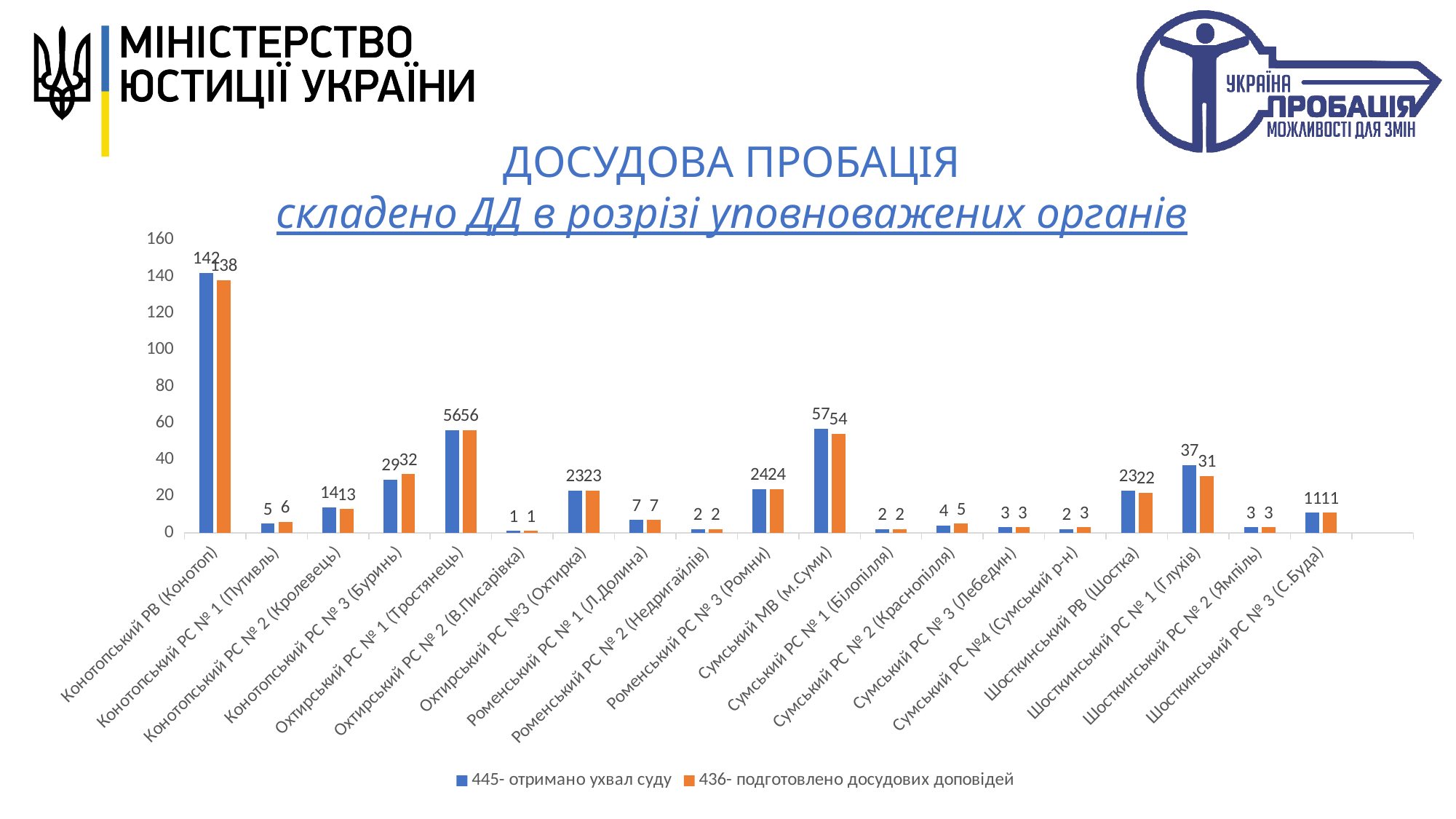
What is the difference between the blue and orange values for Шосткинський РС № 1 (Глухів)? 6 What is the value of the blue series (445- отримано ухвал суду) for Конотопський РВ (Конотоп)? 142 Which category has the highest value in the blue series (445- отримано ухвал суду)? Конотопський РВ (Конотоп) What kind of chart is shown on the slide? bar chart What is the value of the orange series for Конотопський РС № 3 (Буринь)? 32 Is the blue series value for Охтирський РС № 1 (Тростянець) greater or less than 40? greater What is the difference between the blue and orange values for Конотопський РВ (Конотоп)? 4 How many categories are shown on the x axis of the chart? 19 What is the legend entry for the orange series? 436- подготовлено досудових доповідей What is the value of the orange series (436- подготовлено досудових доповідей) for Шосткинський РС № 1 (Глухів)? 31 Which is larger for Сумський МВ (м.Суми): the blue series value or the orange series value? the blue series (57) How many series does the legend list? 2